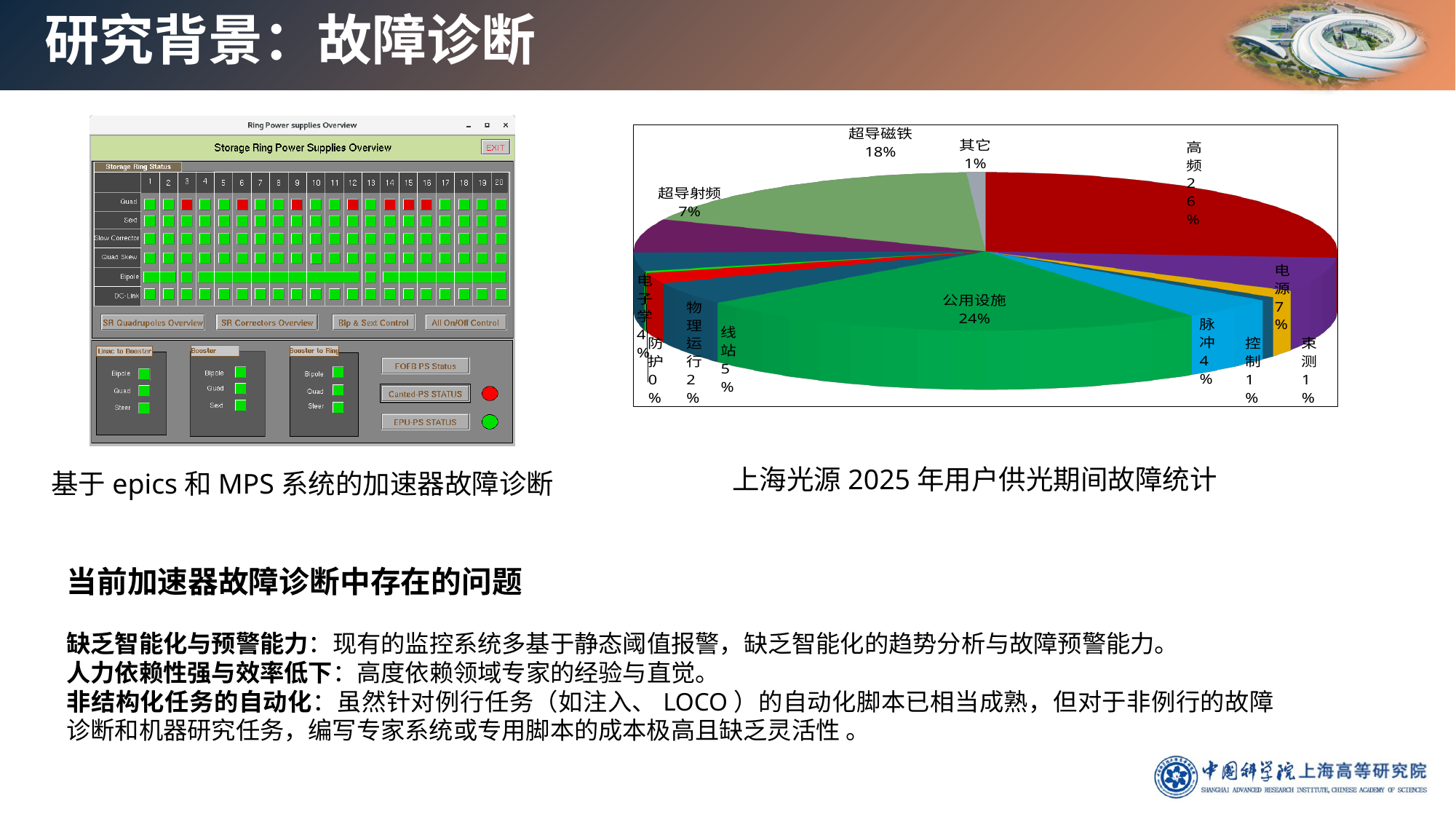
Which category has the largest share in the pie chart? 高频 Which category has the smallest share in the pie chart? 防护 In the pie chart, what share of faults is attributed to 公用设施? 24% In the pie chart, what share of faults is attributed to 线站? 5% How many categories are shown in the pie chart? 13 In the pie chart, what share of faults is attributed to 超导磁铁? 18% In the pie chart, what is the difference between the shares of 高频 and 公用设施? 2% What kind of chart is shown on the right side of the slide? pie chart In the pie chart, what share of faults is attributed to 高频? 26% In the pie chart, which has a larger share, 超导磁铁 or 超导射频? 超导磁铁 In the pie chart, what share of faults is attributed to 防护? 0% What is the caption under the pie chart? 上海光源 2025 年用户供光期间故障统计